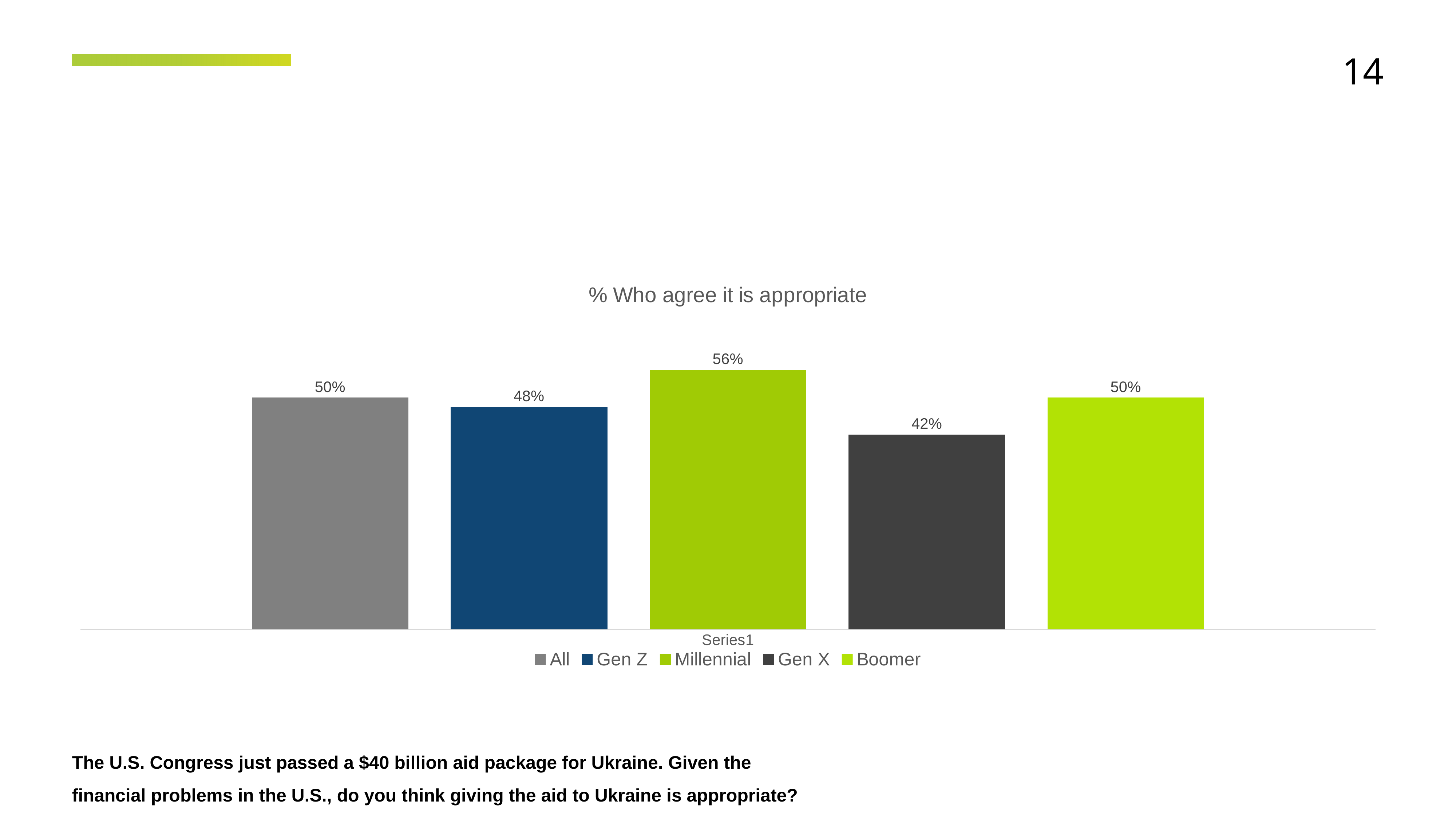
What is the value for Gen X in the chart? 42% What is the value for Gen Z in the chart? 48% Which group has the highest value in the chart? Millennial What is the value for Boomer in the chart? 50% What is the difference between the Millennial value and the Gen X value? 14% What kind of chart is shown on the slide? Bar chart Which is larger, the value for Gen Z or the value for Millennial? Millennial What is the title of the chart? % Who agree it is appropriate How many series does the legend list? 5 Which group has the lowest value in the chart? Gen X What is the value for Millennial in the chart? 56% What is the difference between the All value and the Gen Z value? 2%